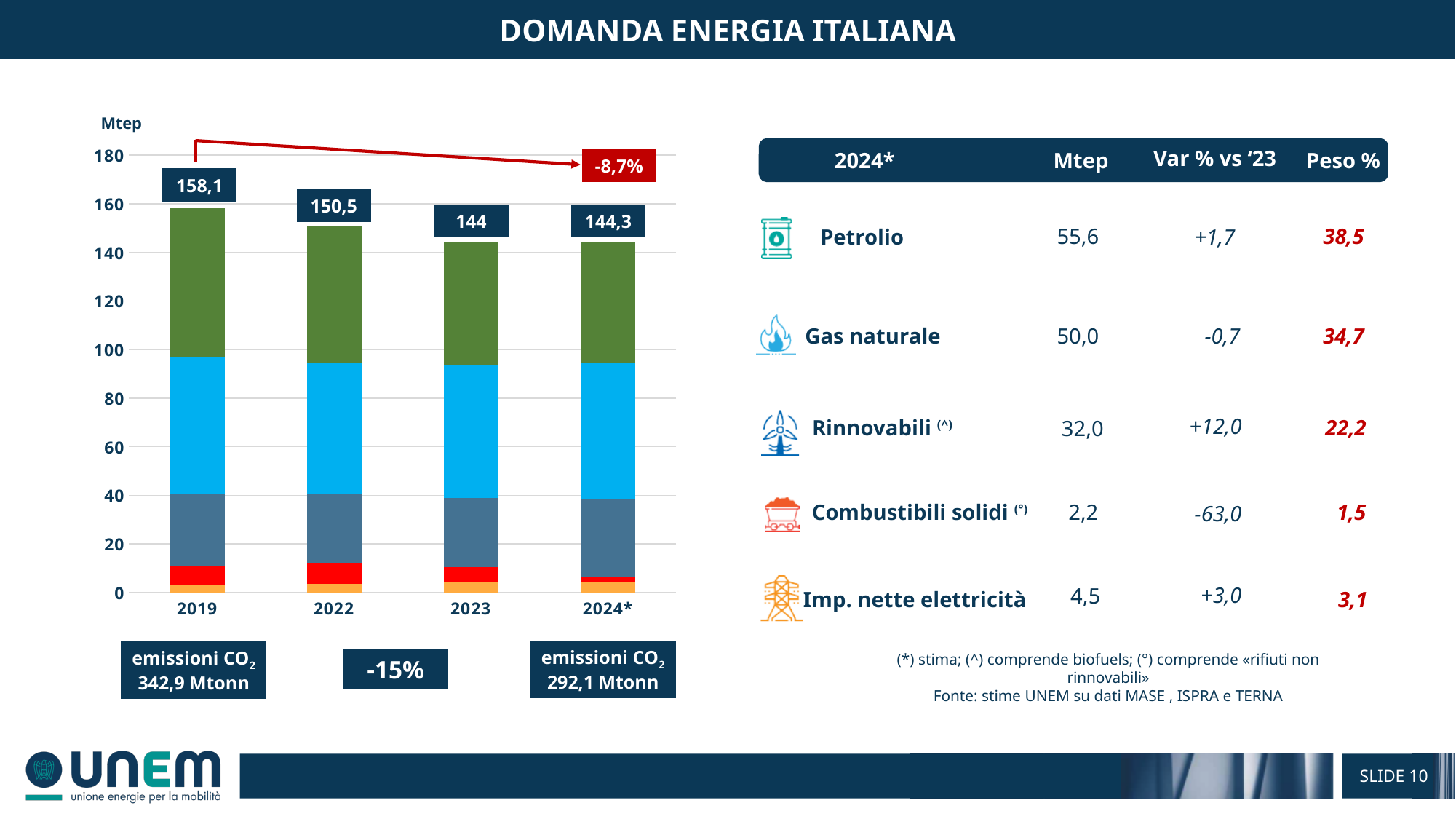
How many bars (years) are shown in the chart? 4 Is the top of the light blue segment in the 2019 bar greater or less than 100? less Which is larger, the total for 2022 or the total for 2023? 2022 What is the total value shown for the 2023 bar? 144 What is the total value shown for the 2024* bar? 144,3 What is the difference between the 2019 total and the 2024* total? 13,8 What is the total value shown for the 2022 bar? 150,5 Which year has the highest total value in the chart? 2019 What is the total value shown for the 2019 bar? 158,1 What is the difference between the 2019 total and the 2022 total? 7,6 What kind of chart is shown on the slide? Stacked bar chart What percentage change is shown by the red arrow annotation from 2019 to 2024*? -8,7%